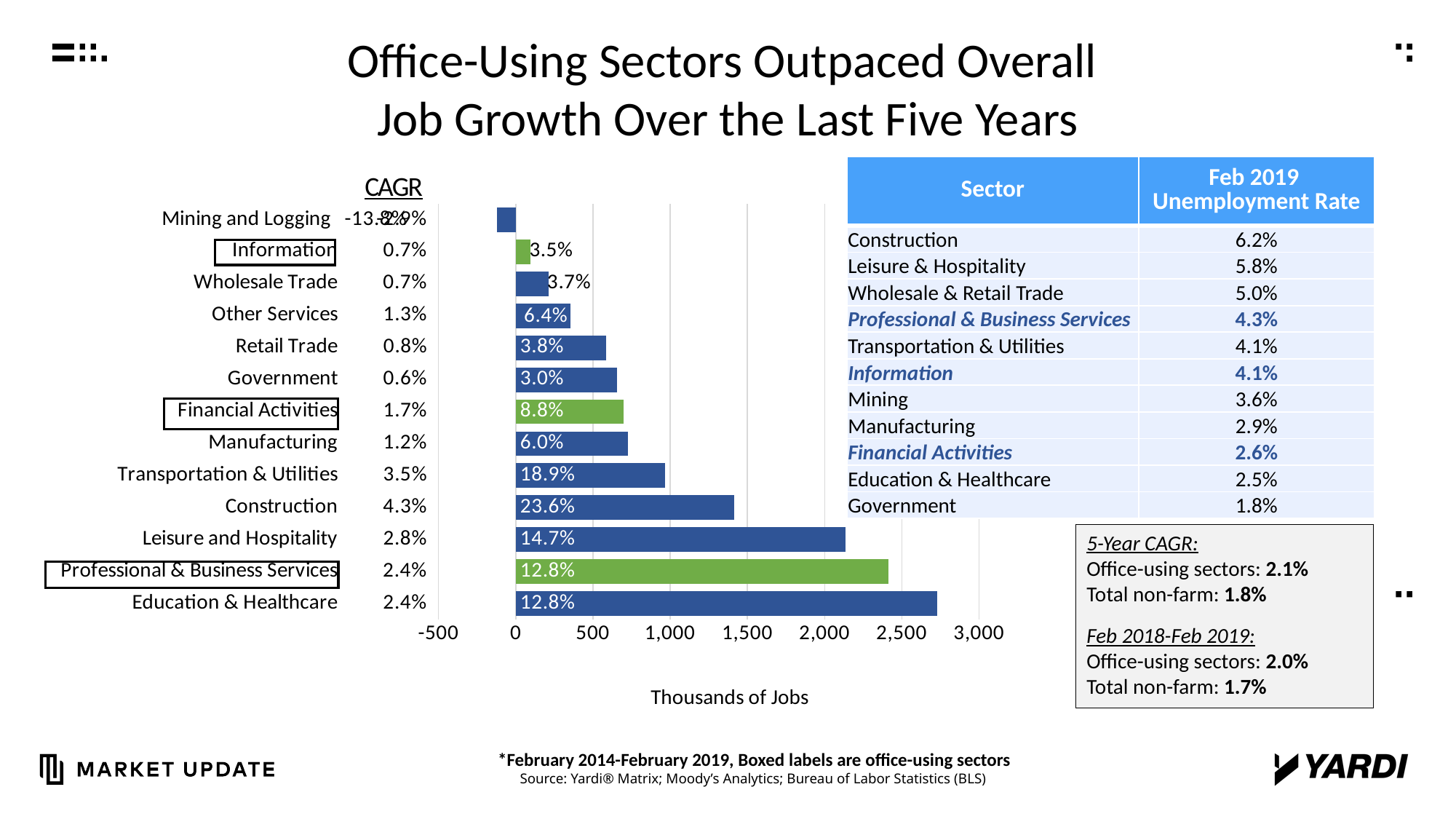
What is the data label printed on the Transportation & Utilities bar? 18.9% What is the data label printed on the Construction bar? 23.6% What is the data label printed on the Financial Activities bar? 8.8% How many sectors are plotted as bars in the chart? 13 Is the value for Construction greater or less than 1,500 thousand jobs? less Is the value for Education & Healthcare greater or less than 2,500 thousand jobs? greater What is the title of the horizontal axis of the chart? Thousands of Jobs Which sector has the lowest (only negative) bar in the chart? Mining and Logging Which sector has the longest bar in the chart? Education & Healthcare What is the data label printed on the Leisure and Hospitality bar? 14.7% Which bar is longer, Construction or Transportation & Utilities? Construction What kind of chart is shown on the slide? bar chart